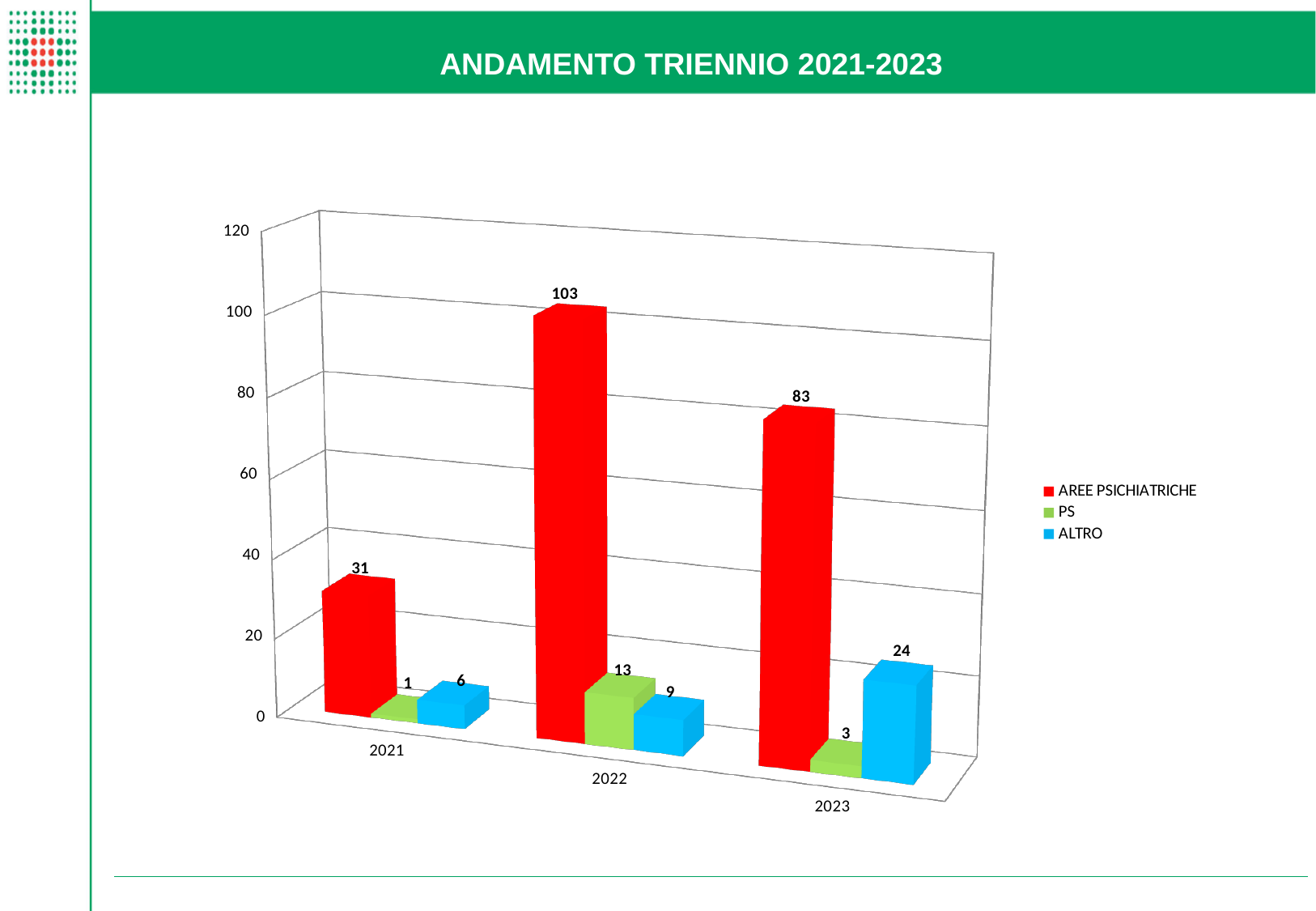
What is the difference between the AREE PSICHIATRICHE values for 2022 and 2023? 20 In which year is the AREE PSICHIATRICHE value highest? 2022 What is the value for AREE PSICHIATRICHE in 2022? 103 What kind of chart is shown on the slide? bar chart How many series does the legend list? 3 In which year is the PS value lowest? 2021 Which is larger in 2022: the PS value or the ALTRO value? PS What is the value for PS in 2021? 1 What is the value for ALTRO in 2023? 24 What is the title of the slide? ANDAMENTO TRIENNIO 2021-2023 How many years are shown on the x axis? 3 Is the value for AREE PSICHIATRICHE in 2023 greater or less than 100? less